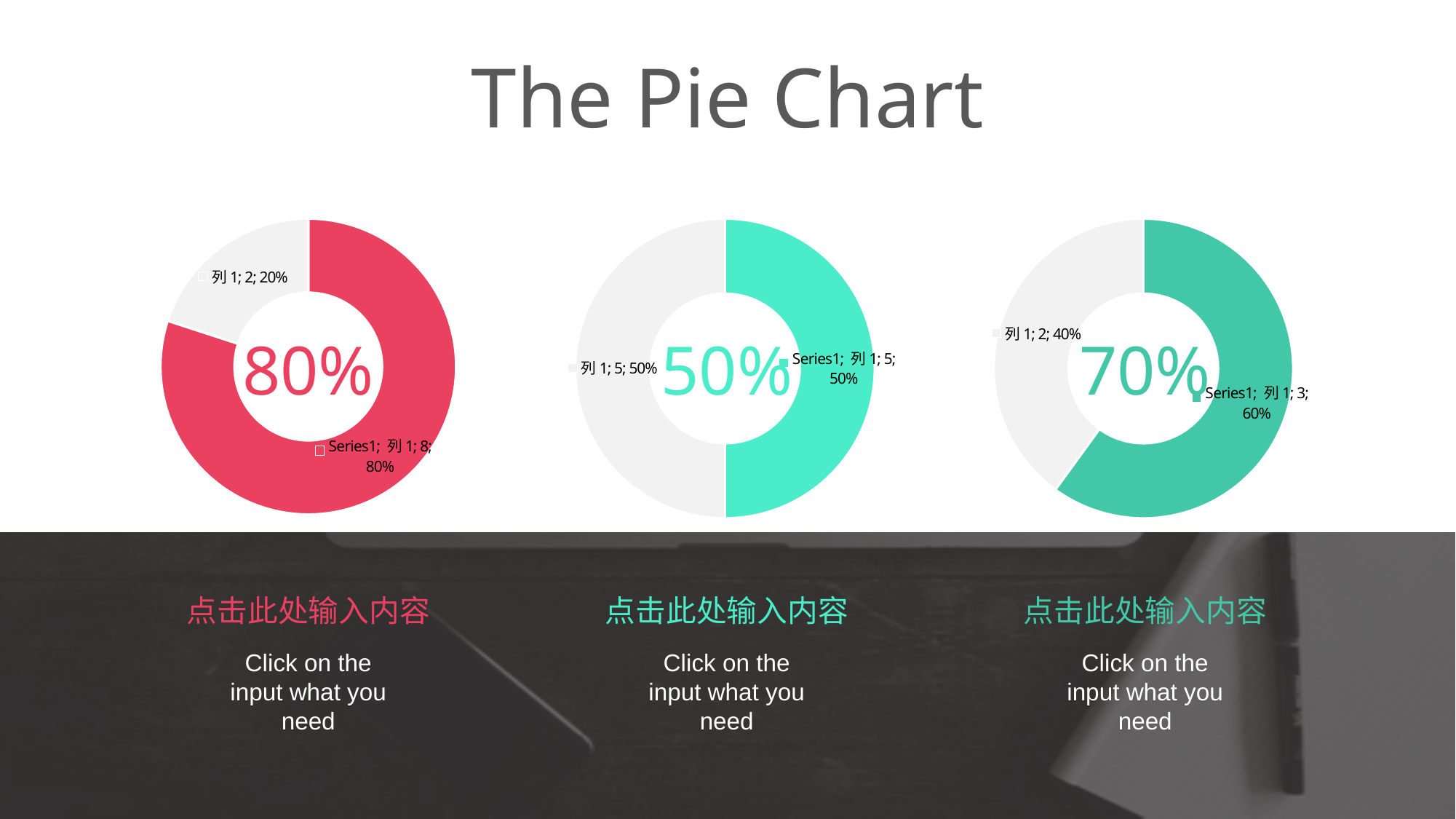
In the left chart, what value is shown on the data label for the red slice? 8 In the right chart, what percentage is shown on the data label for the green slice? 60% In the left chart, what percentage is shown on the data label for the red slice? 80% In the left chart, what percentage is shown on the data label for the grey slice? 20% How many slices does the left chart have? 2 In the middle chart, what percentage is shown on the data label for the teal slice? 50% In the left chart, what value is shown on the data label for the grey slice? 2 What is the large text shown in the centre of the right chart? 70% In the right chart, what percentage is shown on the data label for the grey slice? 40% In the right chart, what value is shown on the data label for the green slice? 3 What kind of chart is shown on the left of the slide? doughnut chart In the middle chart, what value is shown on the data label for the grey slice? 5